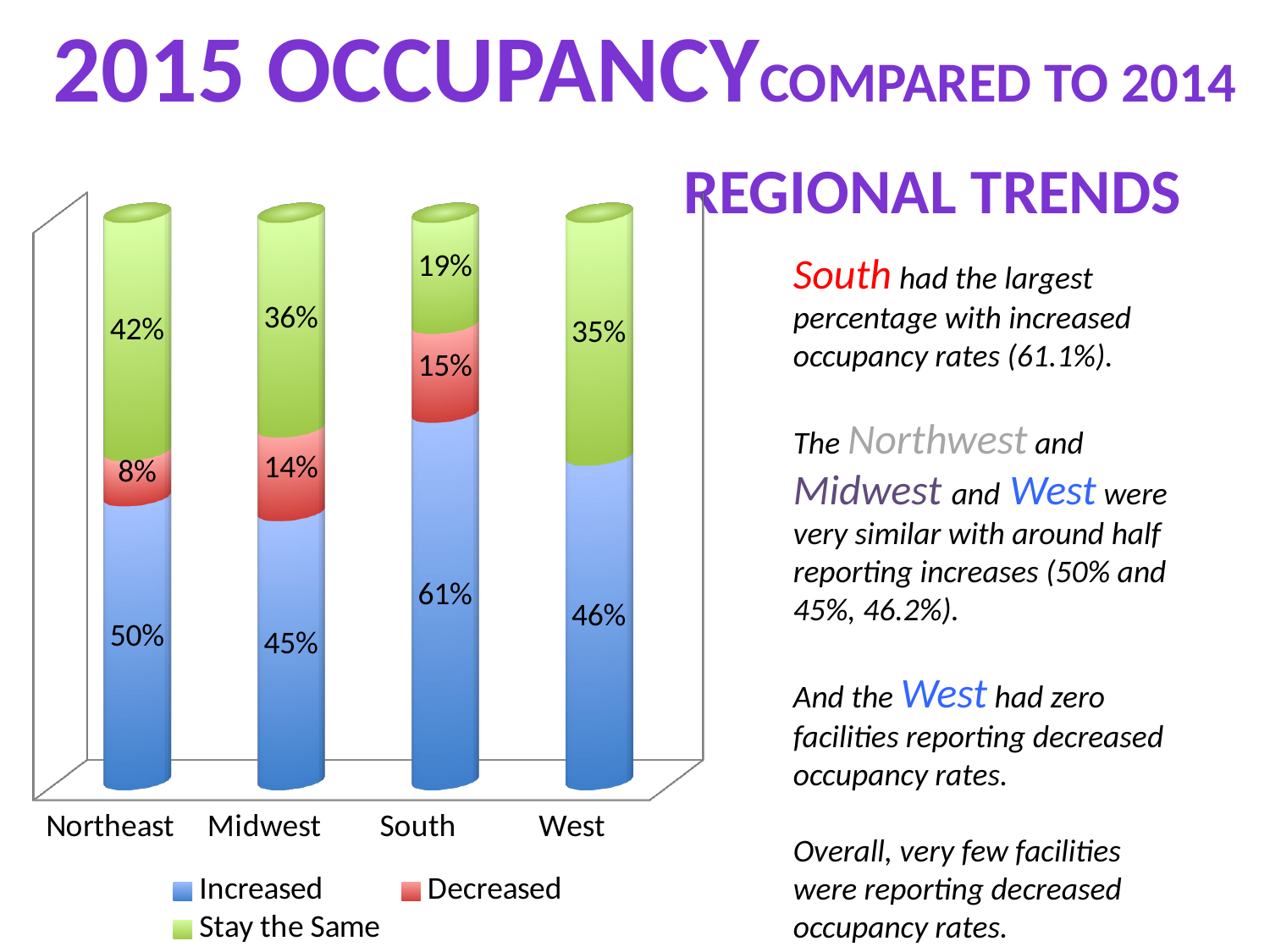
What percentage of facilities in the South reported increased occupancy? 61% What is the Stay the Same value for the West? 35% How many series does the chart legend list? 3 Which series is shown in green in the chart legend? Stay the Same How many percentage points higher is the Increased value for the South than for the Northeast? 11 percentage points Which region has the lowest Stay the Same percentage? South What is the Decreased value for the Midwest? 14% What type of chart is shown on the slide? Stacked bar chart Which region has the highest Increased percentage? South How many regions are shown on the x axis of the chart? 4 Which region has the larger Decreased value, the Northeast or the Midwest? Midwest What is the Stay the Same value for the Northeast? 42%